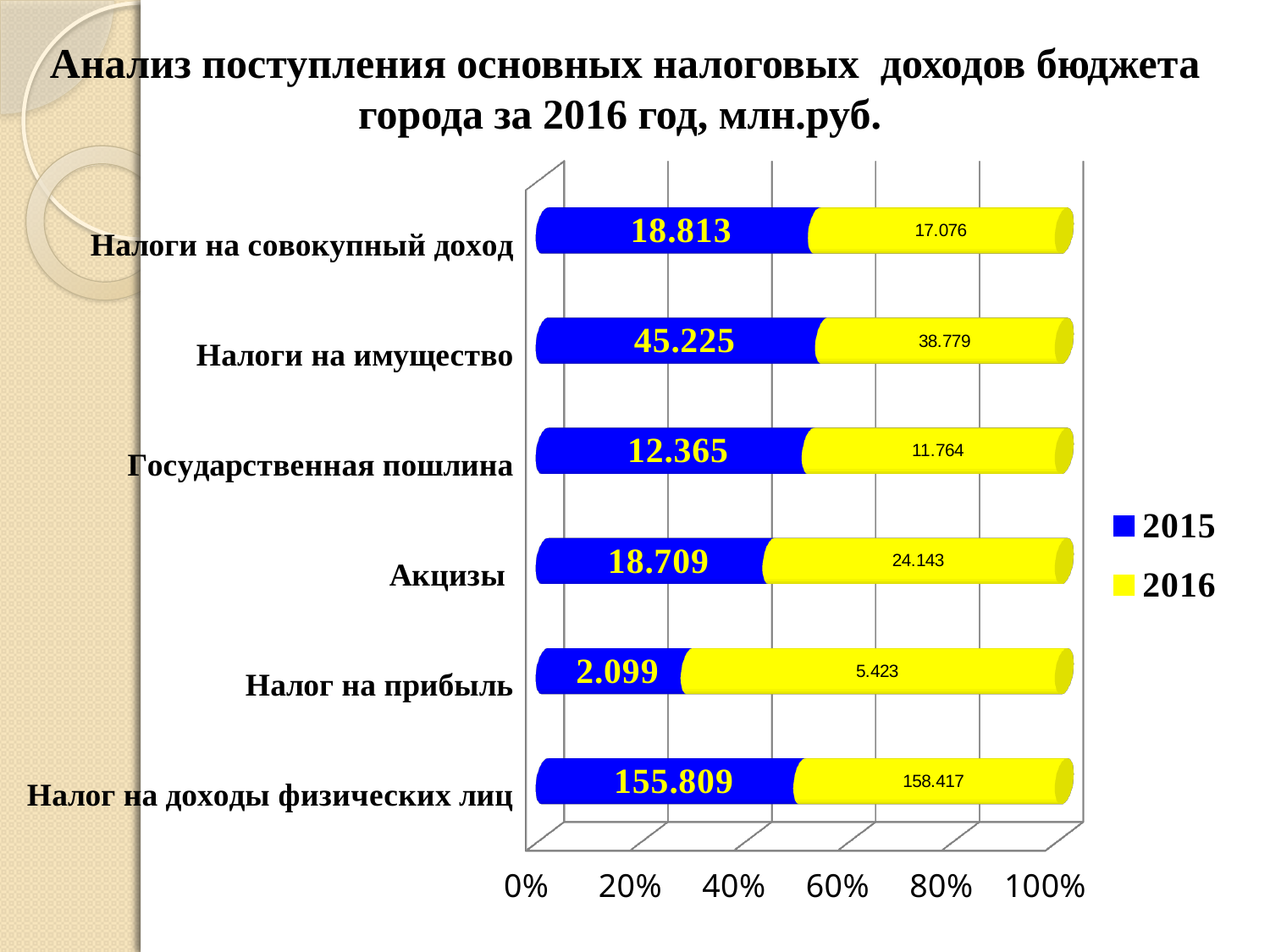
What is the 2015 value for Государственная пошлина? 12.365 What is the 2015 value for Налоги на имущество? 45.225 What is the 2016 value for Акцизы? 24.143 Which category has the highest 2015 value? Налог на доходы физических лиц Which category has the lowest 2016 value? Налог на прибыль By how much does the 2016 value for Акцизы exceed the 2015 value? 5.434 What is the 2016 value for Налог на прибыль? 5.423 How many categories are shown on the chart? 6 What is the difference between the 2015 and 2016 values for Налоги на совокупный доход? 1.737 What kind of chart is shown on the slide? Bar chart For Налог на доходы физических лиц, which year has the larger value, 2015 or 2016? 2016 How many series does the legend list? 2